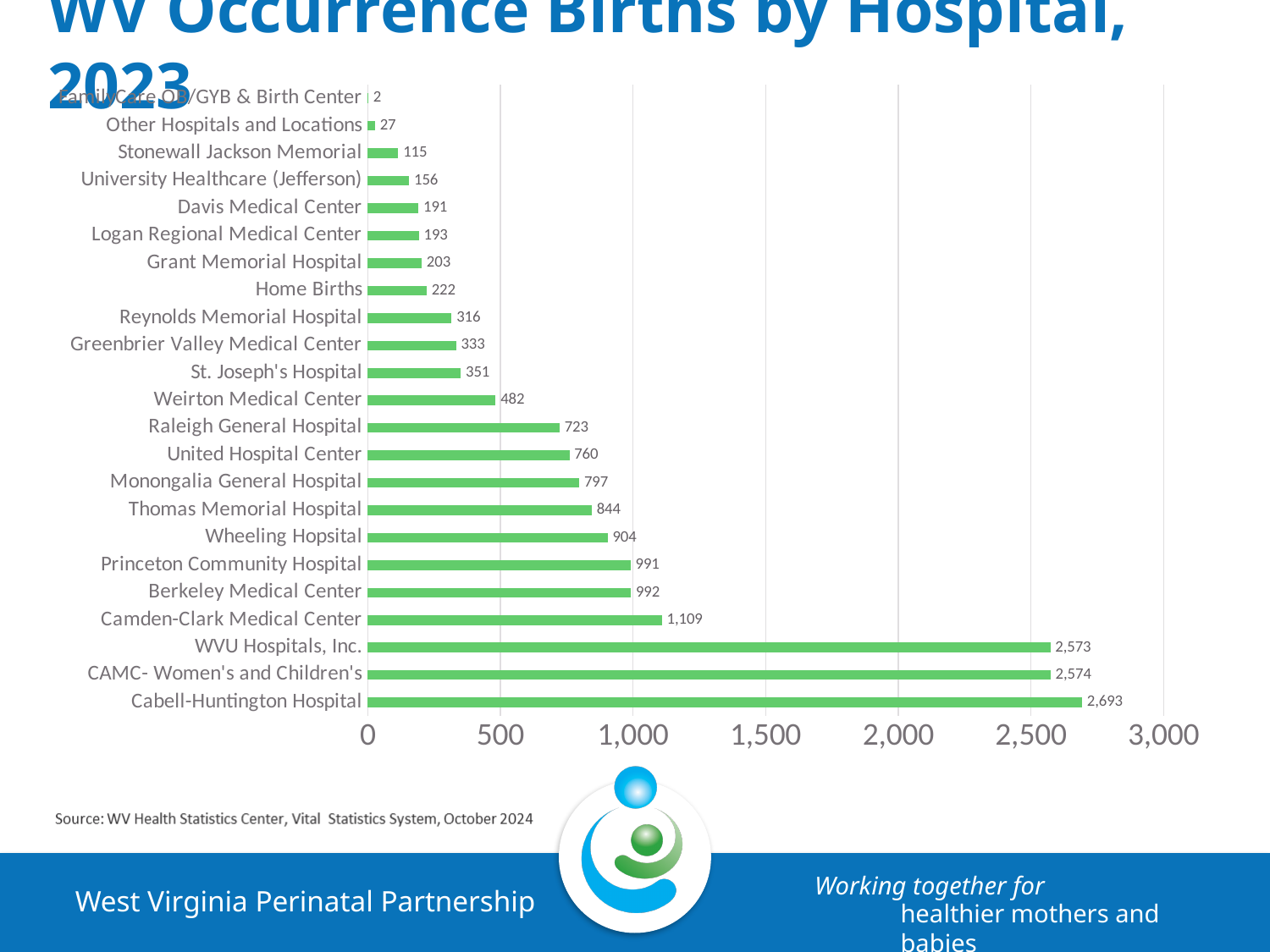
What type of chart is shown on the slide? bar chart How many categories (bars) are shown in the chart? 23 What is the value for Home Births? 222 What is the value for Weirton Medical Center? 482 What is the title of the chart? WV Occurrence Births by Hospital, 2023 Is the value for Weirton Medical Center greater or less than 500? less How many births are shown for Cabell-Huntington Hospital? 2,693 What is the difference between the values for Cabell-Huntington Hospital and Camden-Clark Medical Center? 1,584 Which is larger, the value for Raleigh General Hospital or the value for Thomas Memorial Hospital? Thomas Memorial Hospital Which hospital has the highest number of occurrence births? Cabell-Huntington Hospital What is the difference between the values for CAMC- Women's and Children's and WVU Hospitals, Inc.? 1 What is the value for Camden-Clark Medical Center? 1,109